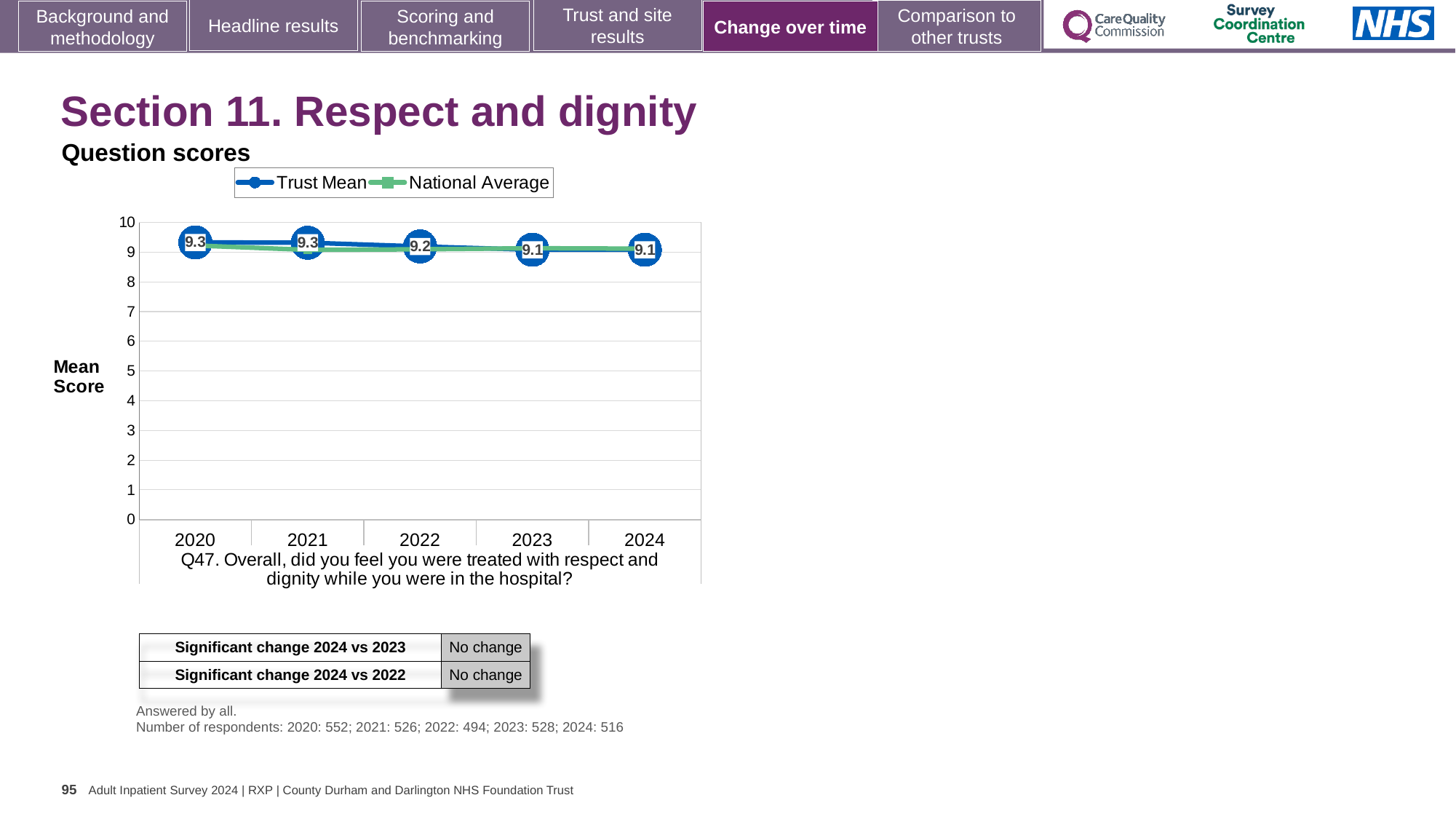
What is the Trust Mean for 2022? 9.2 What is the label on the y axis of the chart? Mean Score Which year has the larger Trust Mean, 2021 or 2024? 2021 How many series does the legend list? 2 Is the National Average value for 2024 greater or less than 8? greater What is the Trust Mean for 2024? 9.1 What is the difference between the Trust Mean in 2020 and in 2024? 0.2 What is the Trust Mean for 2023? 9.1 Does the Trust Mean rise or fall from 2020 to 2024? Fall What kind of chart is shown on the slide? Line chart How many years are plotted on the x axis? 5 What is the Trust Mean for 2020? 9.3